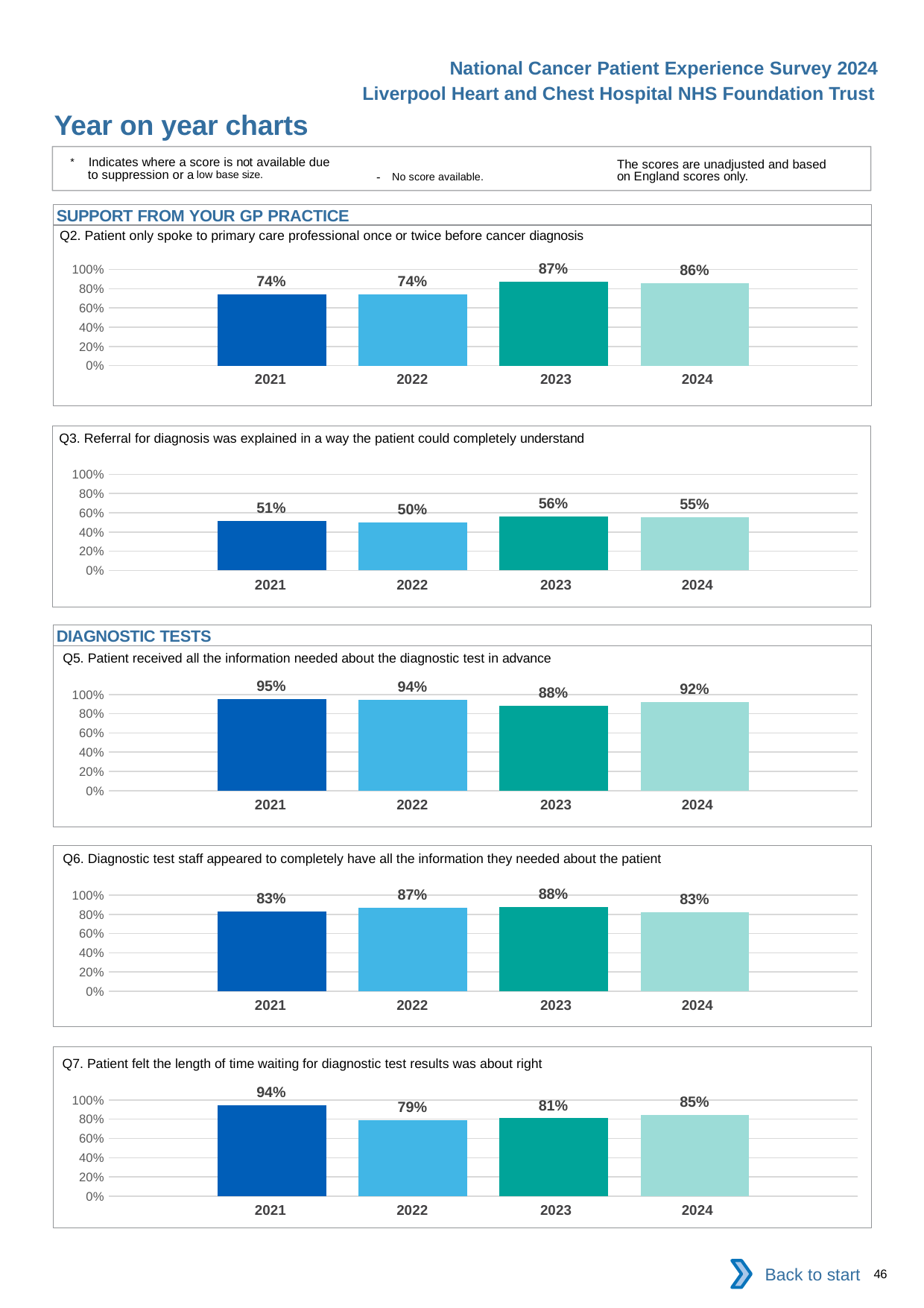
In the Q5 chart (patient received all the information needed about the diagnostic test in advance), which year has the lowest value? 2023 In the Q6 chart, what is the value for 2024? 83% In the Q2 chart (patient only spoke to primary care professional once or twice before cancer diagnosis), what is the value for 2023? 87% In the Q7 chart, do the values rise or fall from 2022 to 2024? rise In the Q5 chart, what is the value for 2021? 95% What kind of chart is the Q7 chart? bar chart In the Q6 chart (diagnostic test staff appeared to completely have all the information they needed about the patient), which is larger, the value for 2022 or the value for 2024? 2022 In the Q3 chart, what is the difference between the 2023 value and the 2021 value? 5 percentage points In the Q7 chart (patient felt the length of time waiting for diagnostic test results was about right), what is the difference between the 2021 value and the 2022 value? 15 percentage points How many years are shown on the x axis of the Q2 chart? 4 In the Q3 chart (referral for diagnosis was explained in a way the patient could completely understand), what is the value for 2022? 50% In the Q2 chart, which year has the highest value? 2023